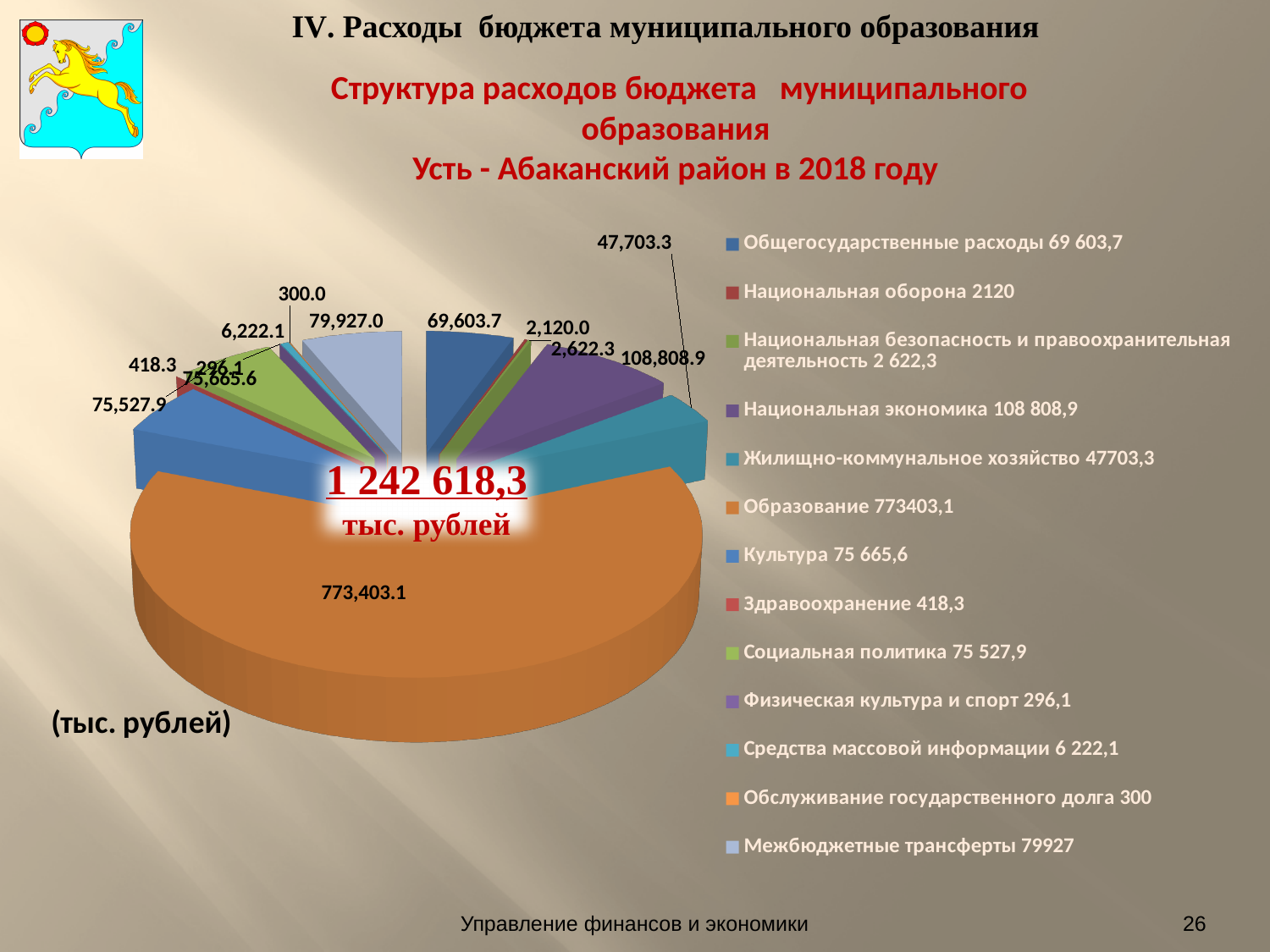
Which category has the smallest value on the pie chart? Физическая культура и спорт What is the difference between the values for Национальная экономика and Межбюджетные трансферты? 28,881.9 Which category has the largest slice of the pie chart? Образование Which is larger: the value for Культура or the value for Социальная политика? Культура What is the value shown for Жилищно-коммунальное хозяйство on the pie chart? 47,703.3 What share of the total 1 242 618,3 does Образование (773,403.1) represent? 62.2% What total amount is printed in the centre of the pie chart? 1 242 618,3 тыс. рублей How many categories does the legend of the pie chart list? 13 What kind of chart is shown on the slide? Pie chart What is the value shown for Образование on the pie chart? 773,403.1 What is the value shown for Национальная экономика on the pie chart? 108,808.9 What is the value shown for Средства массовой информации on the pie chart? 6,222.1